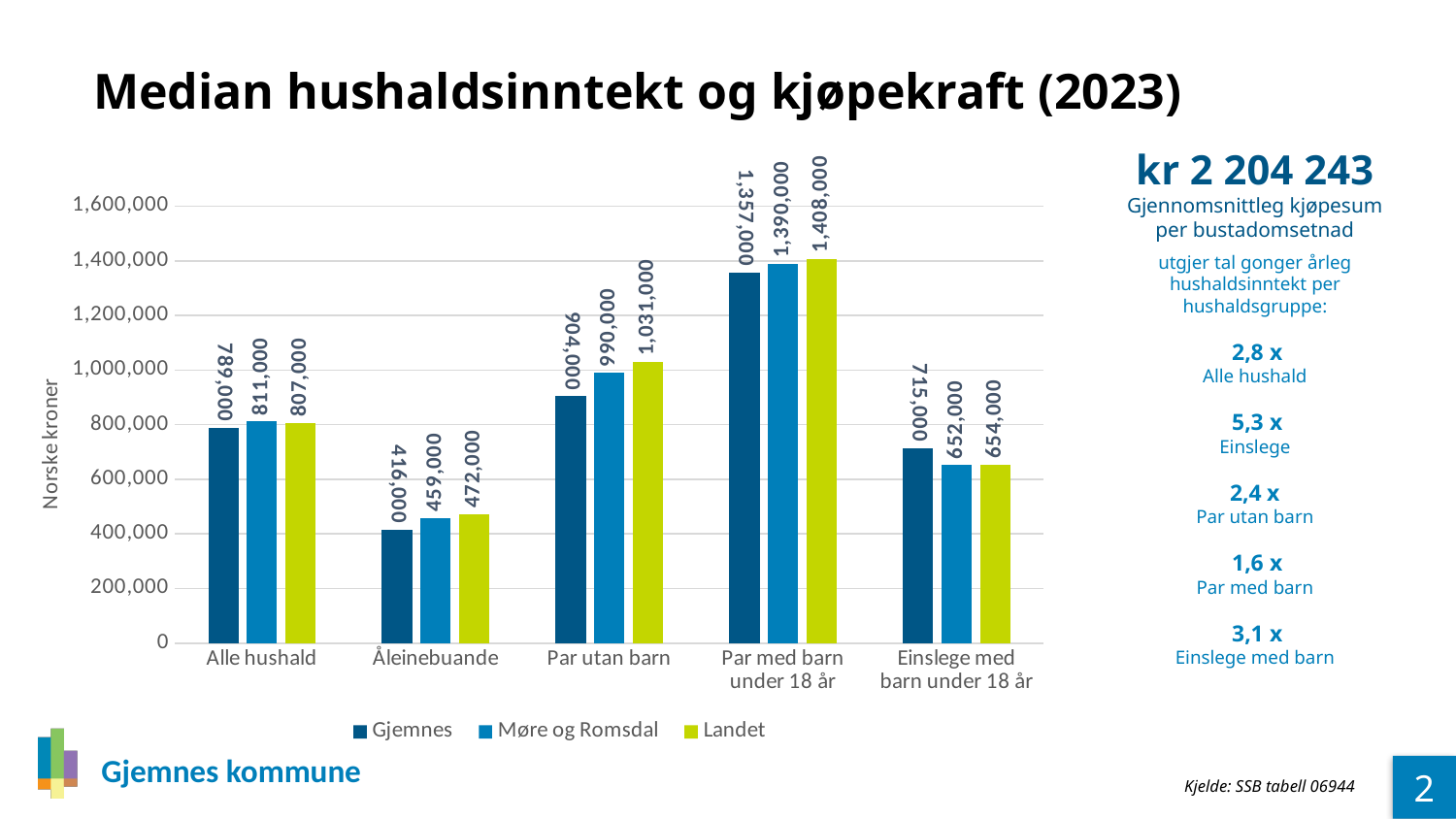
What is the label of the y axis? Norske kroner How many series does the legend list? 3 What is the value for Landet in the 'Par utan barn' category? 1,031,000 How many categories are shown on the x axis? 5 Is the value for Gjemnes in the 'Par utan barn' category greater or less than 1,000,000? less What is the difference between the Landet and Gjemnes values in the 'Par med barn under 18 år' category? 51,000 Which category has the lowest value for Landet? Åleinebuande Which category has the highest value for Gjemnes? Par med barn under 18 år In the 'Einslege med barn under 18 år' category, which is larger: Gjemnes or Møre og Romsdal? Gjemnes What is the value for Møre og Romsdal in the 'Åleinebuande' category? 459,000 What kind of chart is shown on the slide? bar chart What is the value for Gjemnes in the 'Alle hushald' category? 789,000